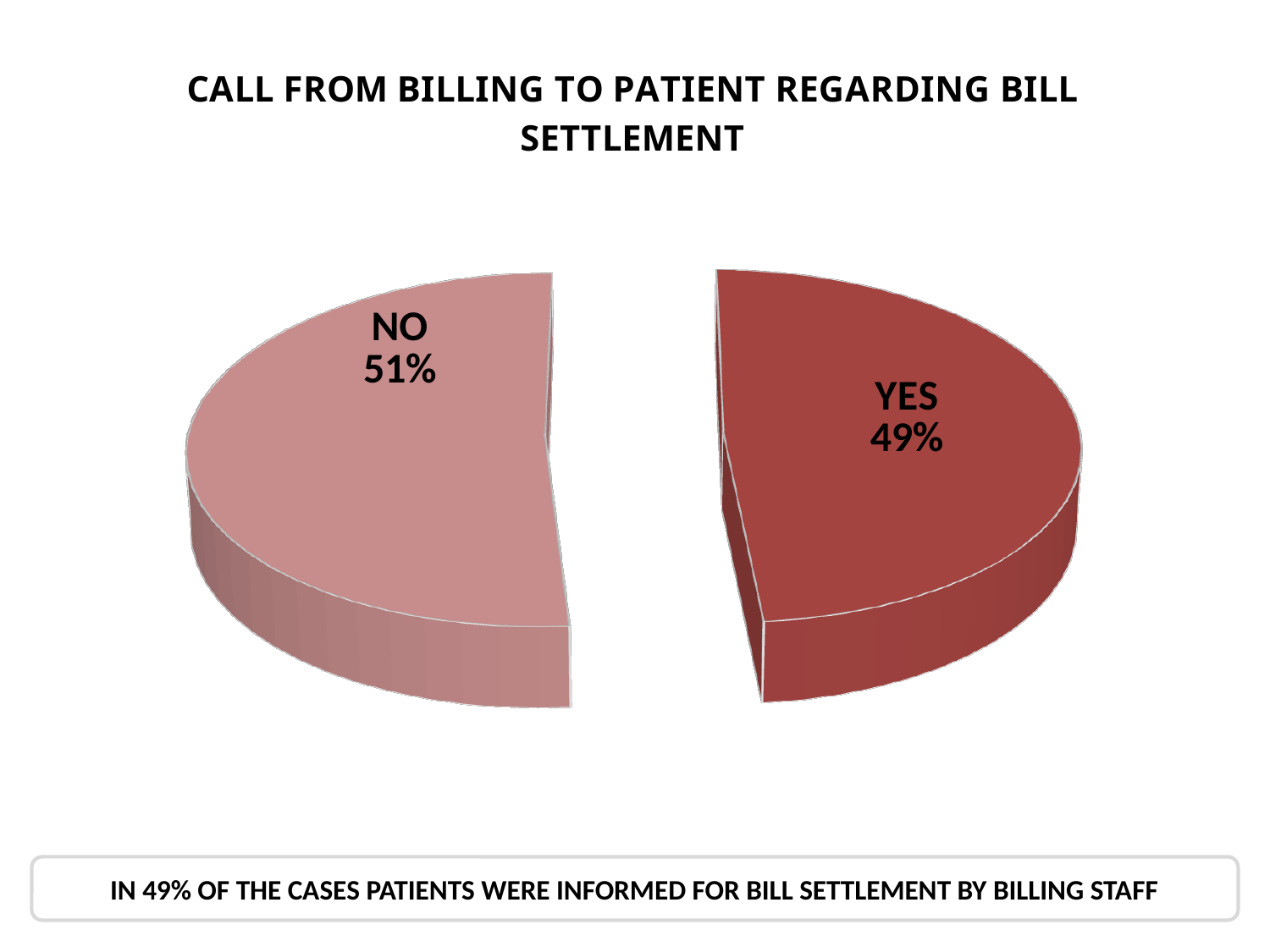
What is the difference in percentage points between the NO slice and the YES slice? 2 Which slice of the pie chart is the smallest? YES What percentage of cases are labelled YES in the pie chart? 49% What is the title of the chart? CALL FROM BILLING TO PATIENT REGARDING BILL SETTLEMENT What kind of chart is shown on the slide? Pie chart Which is larger, the YES slice or the NO slice? NO Which slice of the pie chart is the largest? NO How many slices does the pie chart have? 2 What share of the pie does the YES slice represent? 49% What percentage of cases are labelled NO in the pie chart? 51% Which slice of the pie chart is coloured dark red? YES